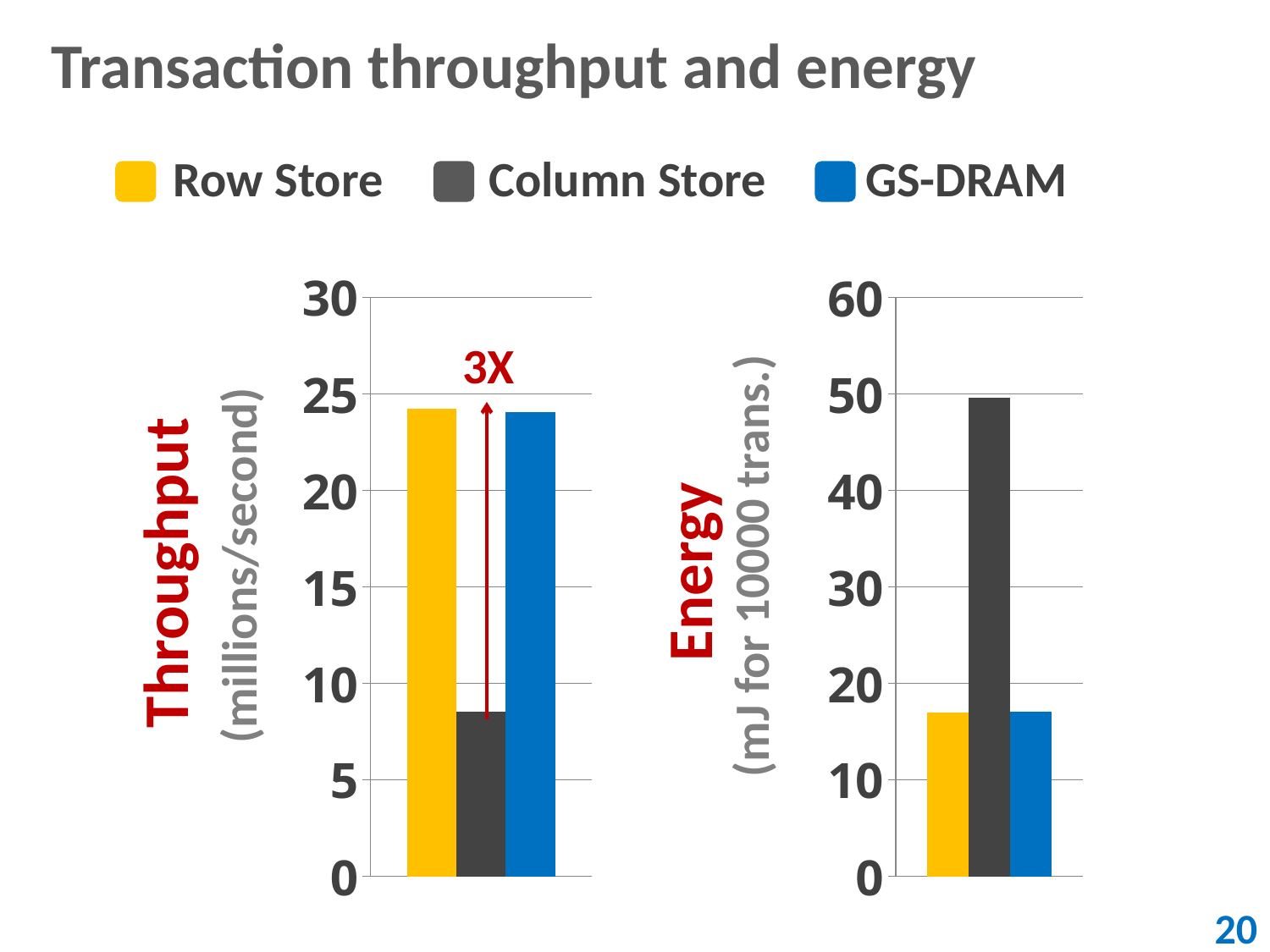
What kind of chart is the Throughput chart on the left? bar chart How many bars are plotted in the Energy chart? 3 In the Energy chart, which is larger: the value for Column Store or the value for GS-DRAM? Column Store In the Energy chart, is the value for Column Store greater or less than 40? greater In the Throughput chart, is the value for Column Store greater or less than 10? less What improvement factor is annotated above the Column Store bar in the Throughput chart? 3X In the Energy chart, is the value for Row Store greater or less than 20? less In the Throughput chart, which is larger: the value for Row Store or the value for Column Store? Row Store In the Throughput chart, which series has the lowest value? Column Store In the Energy chart, which series has the highest value? Column Store How many series does the legend list? 3